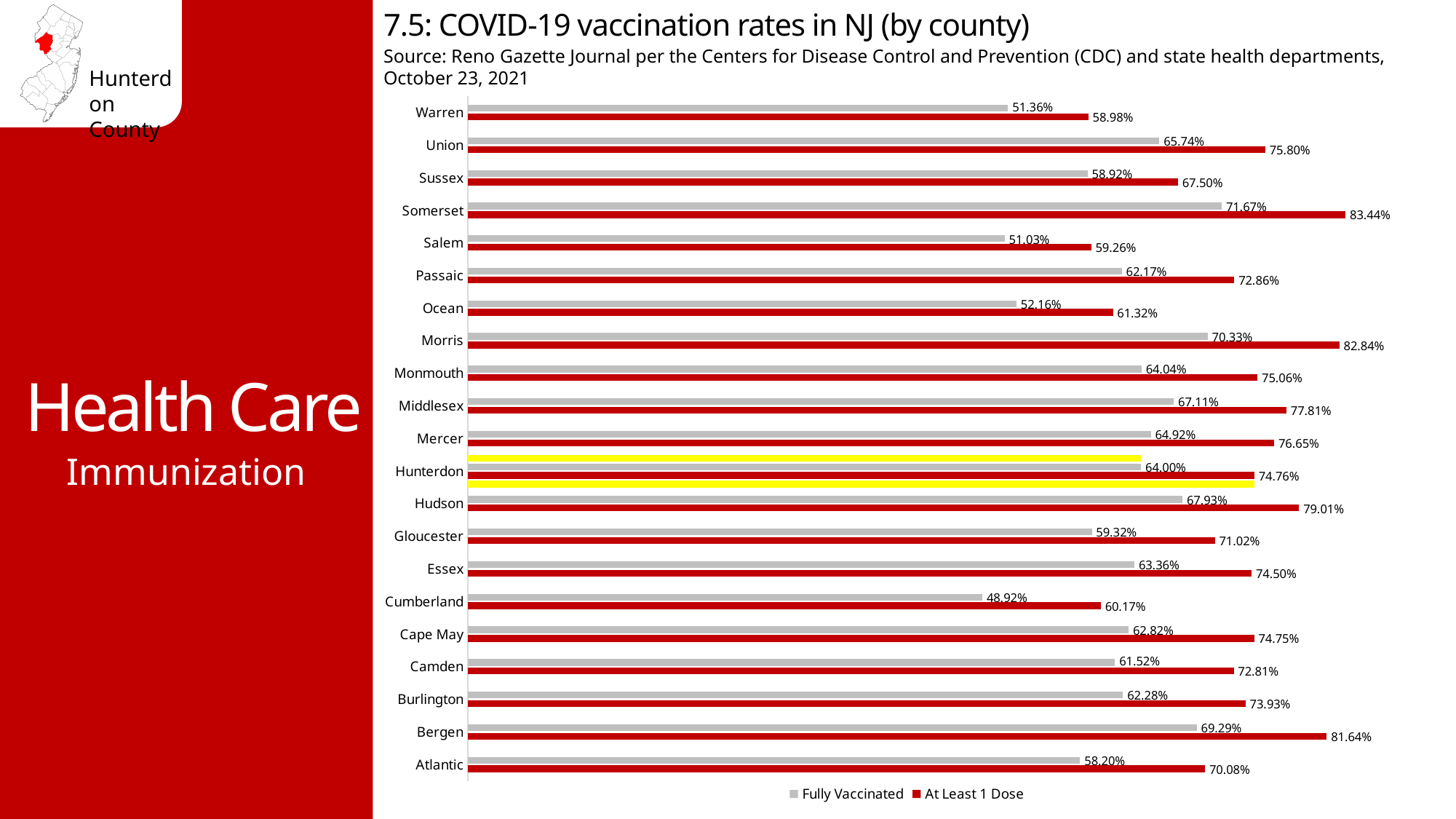
How many series does the legend list? 2 What is the Fully Vaccinated rate for Hunterdon County? 64.00% What is the difference between the At Least 1 Dose rate and the Fully Vaccinated rate for Hunterdon County? 10.76 percentage points Which county has a higher At Least 1 Dose rate, Bergen or Hudson? Bergen Which county's bars are highlighted in yellow on the chart? Hunterdon Which county has the lowest Fully Vaccinated rate? Cumberland What is the Fully Vaccinated rate for Cumberland County? 48.92% Which county has the highest Fully Vaccinated rate? Somerset Which county has the lowest At Least 1 Dose rate? Warren How many counties are shown in the chart? 21 What is the At Least 1 Dose rate for Somerset County? 83.44% What type of chart is shown on the slide? Bar chart